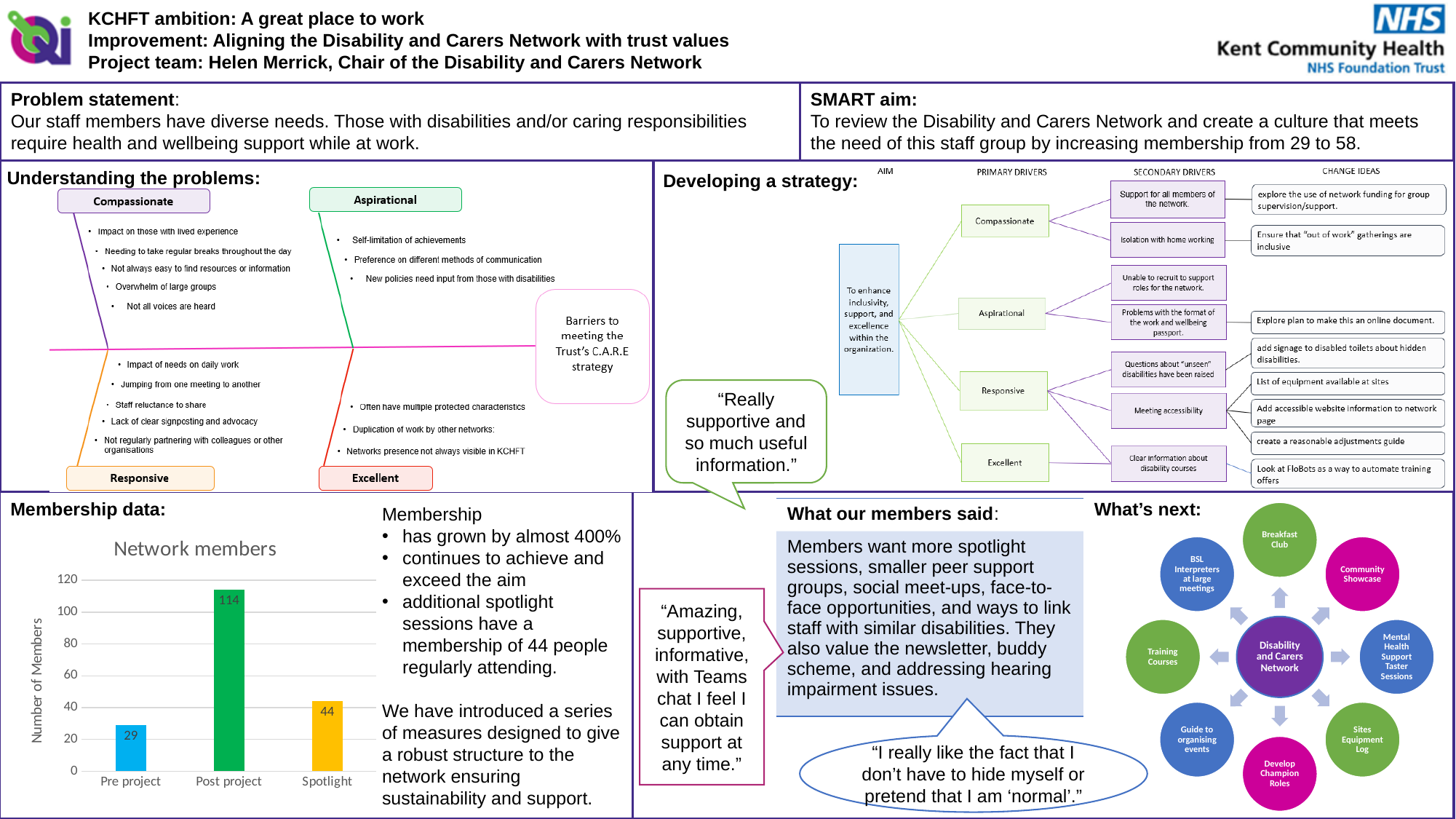
What is the value for Post project in the Network members chart? 114 What is the difference between the Post project and Pre project values in the Network members chart? 85 What is the y-axis label of the Network members chart? Number of Members Is the value for Post project in the Network members chart greater or less than 100? greater What is the value for Pre project in the Network members chart? 29 What kind of chart is the Network members chart? bar chart What is the difference between the Spotlight and Pre project values in the Network members chart? 15 How many categories are shown in the Network members chart? 3 What is the value for Spotlight in the Network members chart? 44 Which category has the lowest value in the Network members chart? Pre project Which category has the highest value in the Network members chart? Post project In the Network members chart, which is larger: Spotlight or Pre project? Spotlight